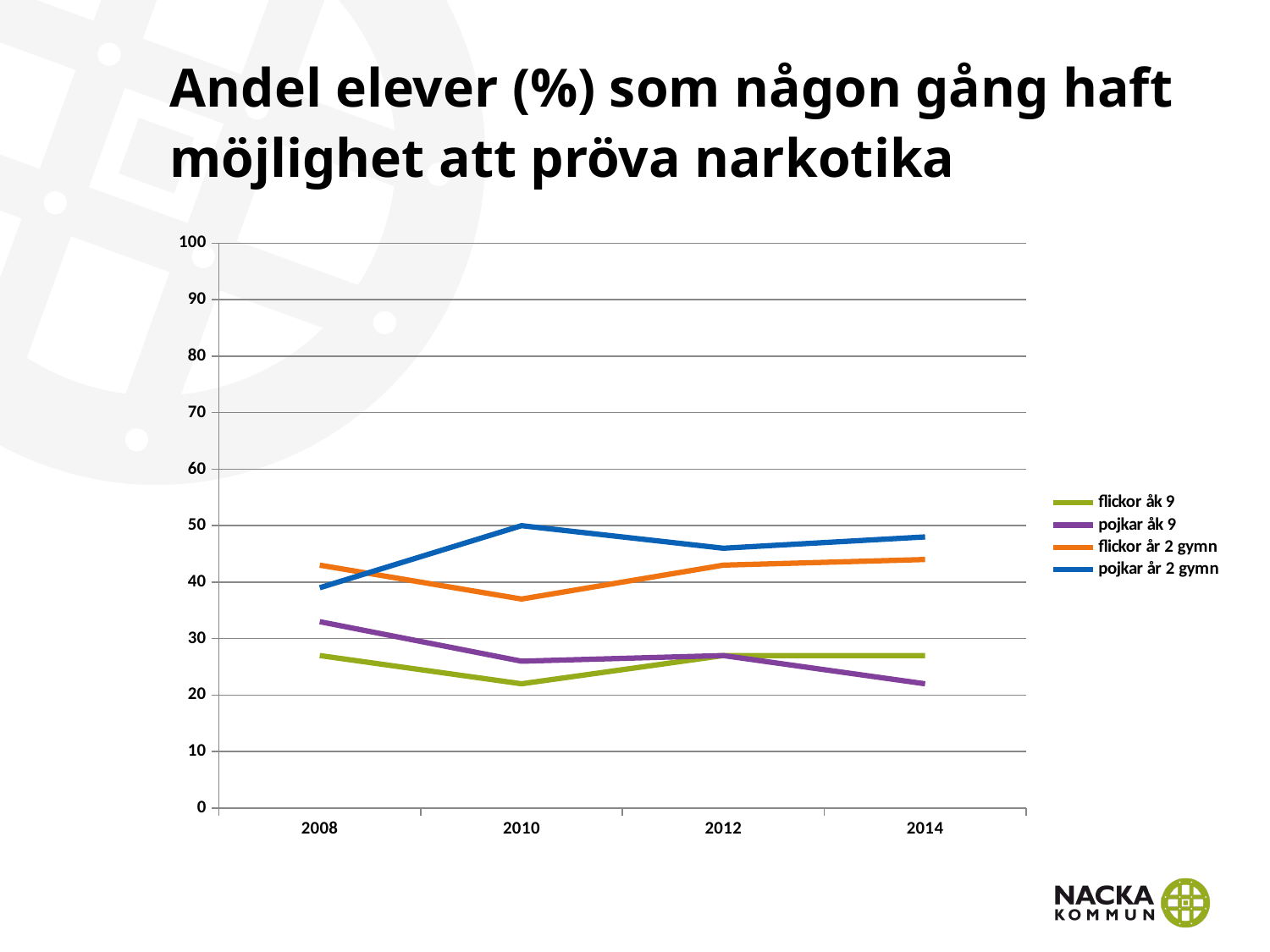
How many years are shown on the x axis? 4 In 2008, which is larger: flickor år 2 gymn or pojkar år 2 gymn? flickor år 2 gymn Which series has the highest value in 2010? pojkar år 2 gymn Which series has the lowest value in 2010? flickor åk 9 Is the value for pojkar år 2 gymn in 2012 greater or less than 40? greater In 2014, which is larger: flickor åk 9 or pojkar åk 9? flickor åk 9 Is the value for pojkar åk 9 in 2008 greater or less than 30? greater What kind of chart is shown on the slide? line chart How many series does the legend list? 4 Does the value for pojkar åk 9 rise or fall from 2008 to 2014? fall Is the value for pojkar åk 9 in 2014 greater or less than 30? less Which colour is used for the pojkar år 2 gymn line? blue